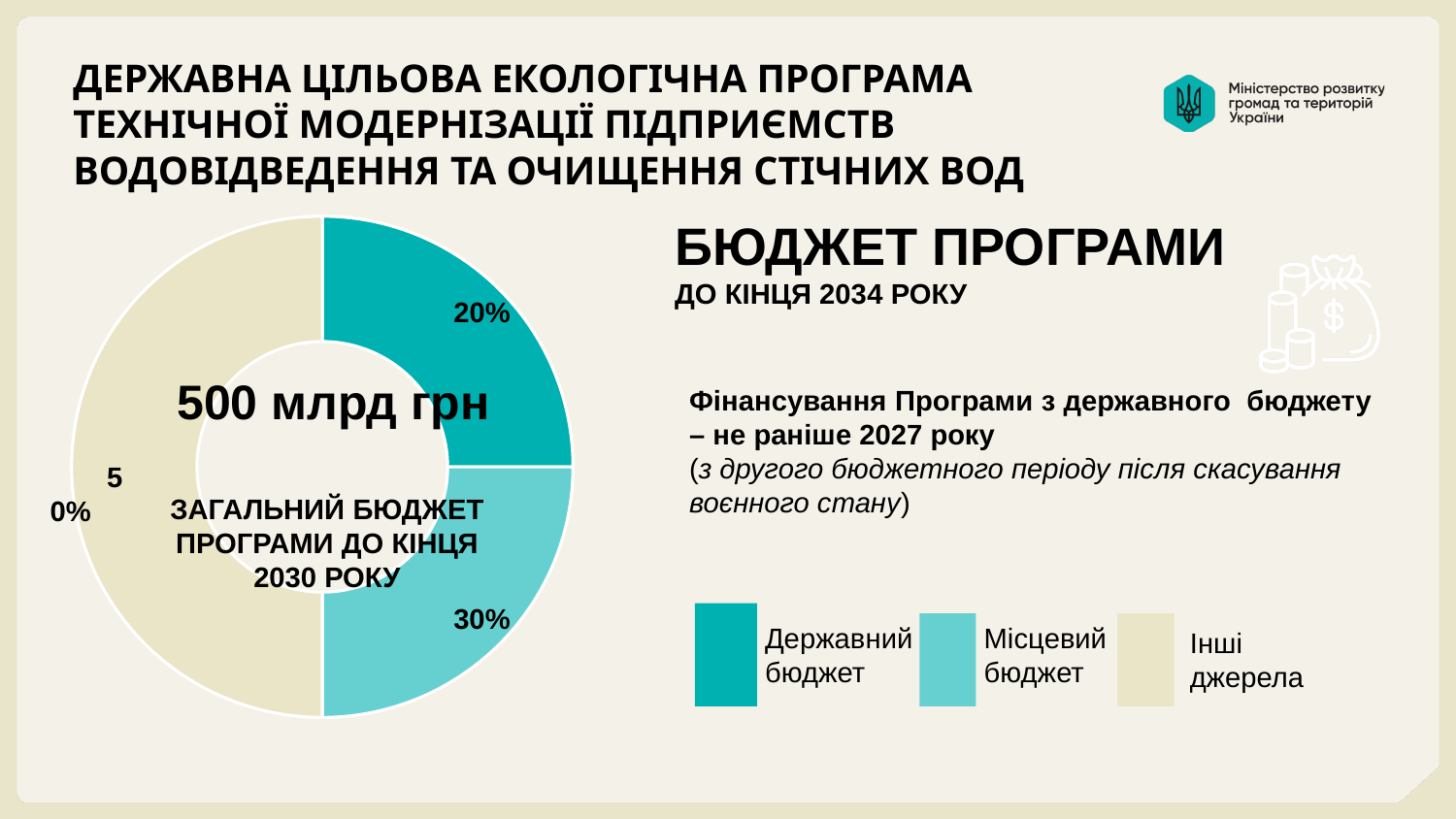
What share of the programme budget comes from the state budget (Державний бюджет)? 20% What share of the programme budget comes from other sources (Інші джерела)? 50% By how many percentage points does the local budget share exceed the state budget share? 10 percentage points Which is larger: the share from the local budget or the share from the state budget? Місцевий бюджет How many slices does the donut chart have? 3 Which funding source has the smallest share of the programme budget? Державний бюджет What share of the programme budget comes from the local budget (Місцевий бюджет)? 30% How many entries does the legend list? 3 What total budget amount is shown in the centre of the donut chart? 500 млрд грн What colour represents Інші джерела in the chart? Beige Which funding source has the largest share of the programme budget? Інші джерела What kind of chart is shown on the slide? Pie (donut) chart